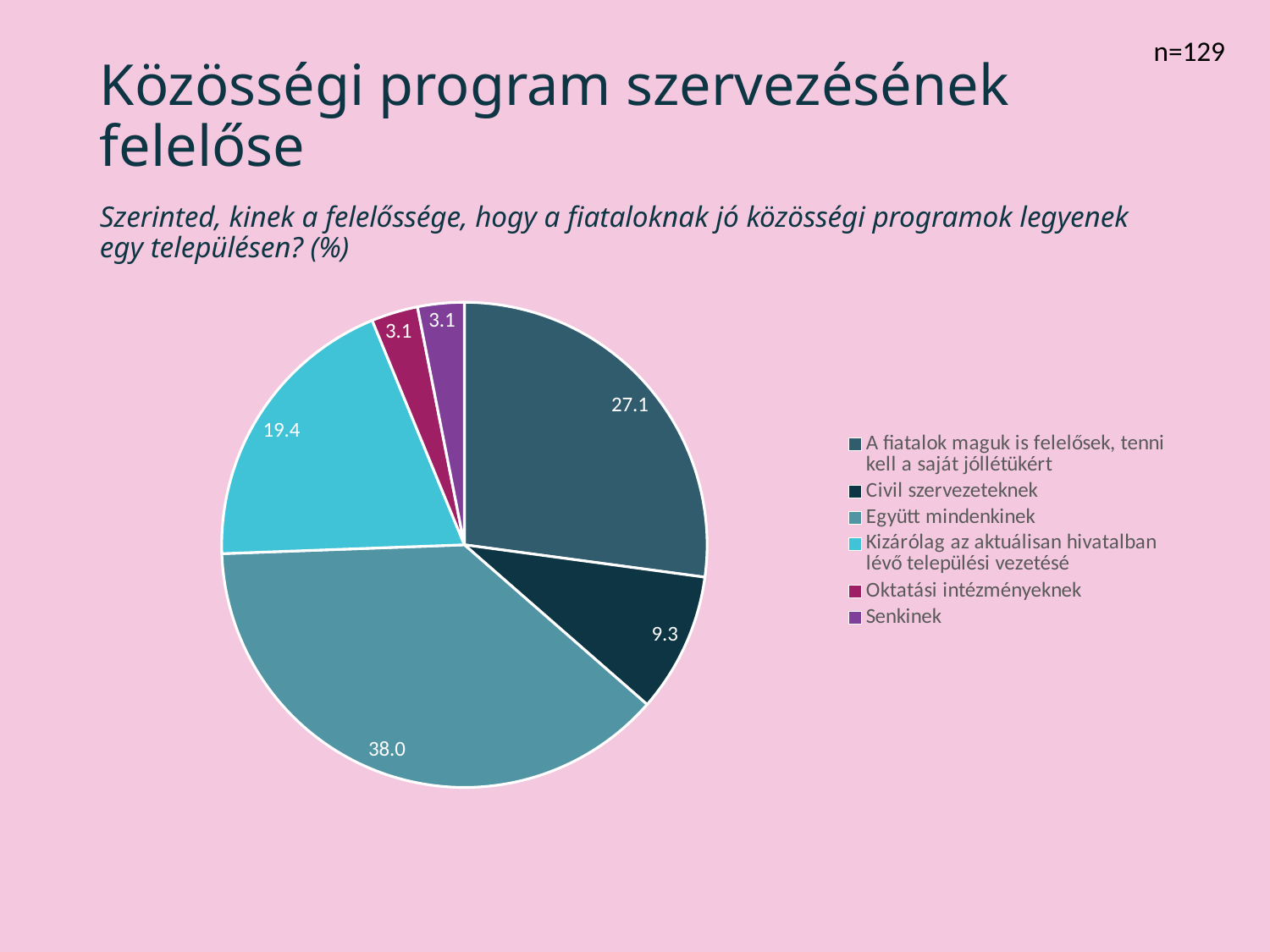
What is the value for "Együtt mindenkinek"? 38.0 Which is larger, the value for "Kizárólag az aktuálisan hivatalban lévő települési vezetésé" or the value for "Civil szervezeteknek"? Kizárólag az aktuálisan hivatalban lévő települési vezetésé Which category has the largest slice of the pie? Együtt mindenkinek What is the value for "Civil szervezeteknek"? 9.3 What share of the pie does "Oktatási intézményeknek" represent? 3.1 What is the value for "Kizárólag az aktuálisan hivatalban lévő települési vezetésé"? 19.4 How many slices does the pie chart have? 6 What is the value for "A fiatalok maguk is felelősek, tenni kell a saját jóllétükért"? 27.1 What is the value for "Senkinek"? 3.1 What is the difference between the values for "Együtt mindenkinek" and "A fiatalok maguk is felelősek, tenni kell a saját jóllétükért"? 10.9 What sample size (n) is shown on the slide? n=129 What type of chart is shown on the slide? pie chart